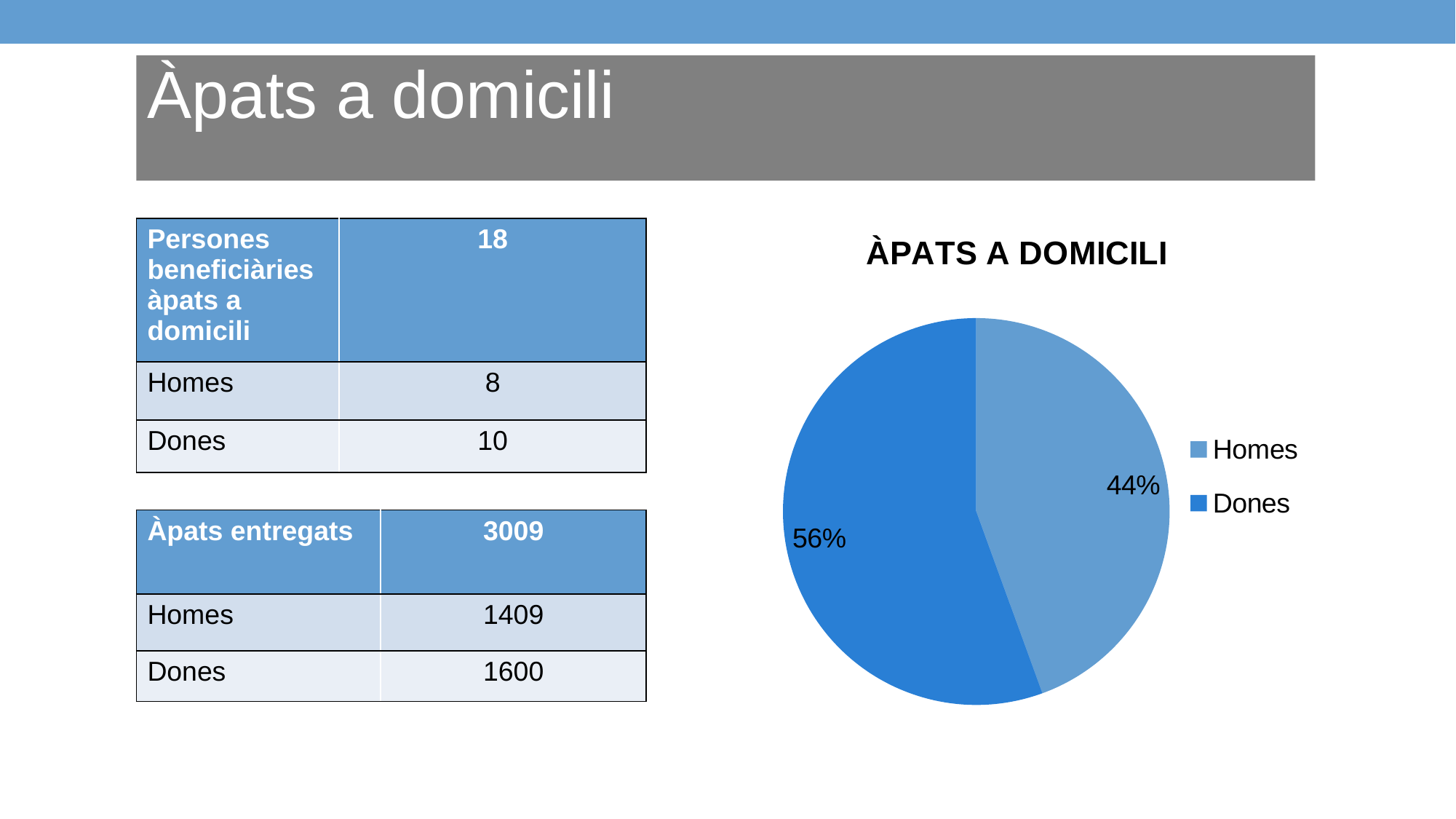
Which legend entry is shown in the darker blue colour? Dones How many entries does the legend list? 2 Which slice of the pie is the largest? Dones What share of the pie does Homes represent? 44% What kind of chart is shown on the slide? pie chart Which slice of the pie is the smallest? Homes What share of the pie does Dones represent? 56% How many slices does the pie chart have? 2 What is the title of the chart? ÀPATS A DOMICILI What is the difference in percentage points between the Dones and Homes slices? 12 percentage points Which is larger in the pie chart, Homes or Dones? Dones Is the share for Homes greater or less than 50%? less